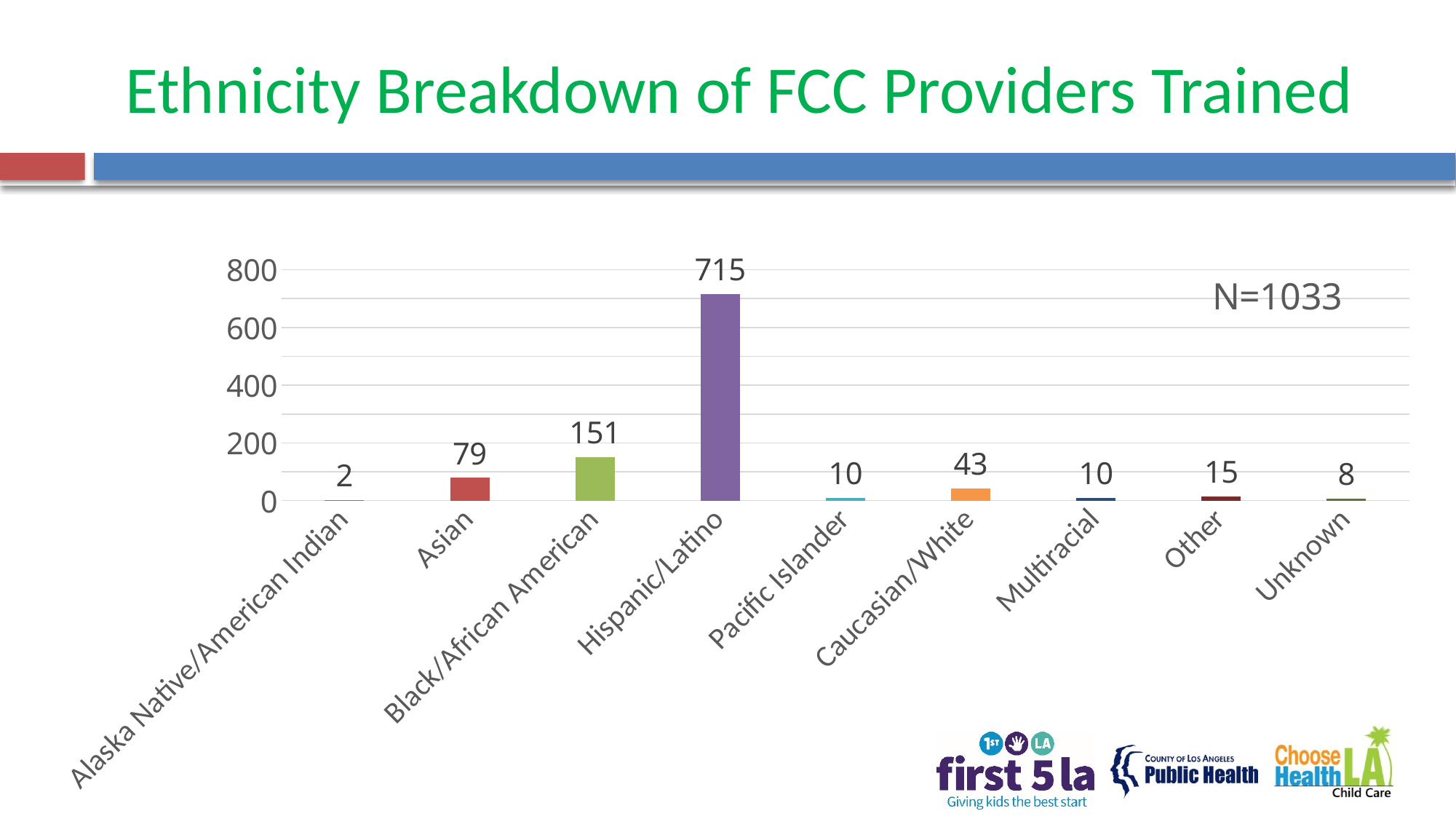
What is the value for Caucasian/White? 43 Which category has the highest value? Hispanic/Latino What is the N value shown on the chart? N=1033 What is the value for Black/African American? 151 What is the difference between the values for Hispanic/Latino and Black/African American? 564 How many categories are shown on the x axis? 9 Is the value for Hispanic/Latino greater or less than 600? greater What is the value for Alaska Native/American Indian? 2 What kind of chart is shown on the slide? bar chart Which is larger, the value for Asian or the value for Caucasian/White? Asian What is the value for Hispanic/Latino? 715 Which category has the lowest value? Alaska Native/American Indian